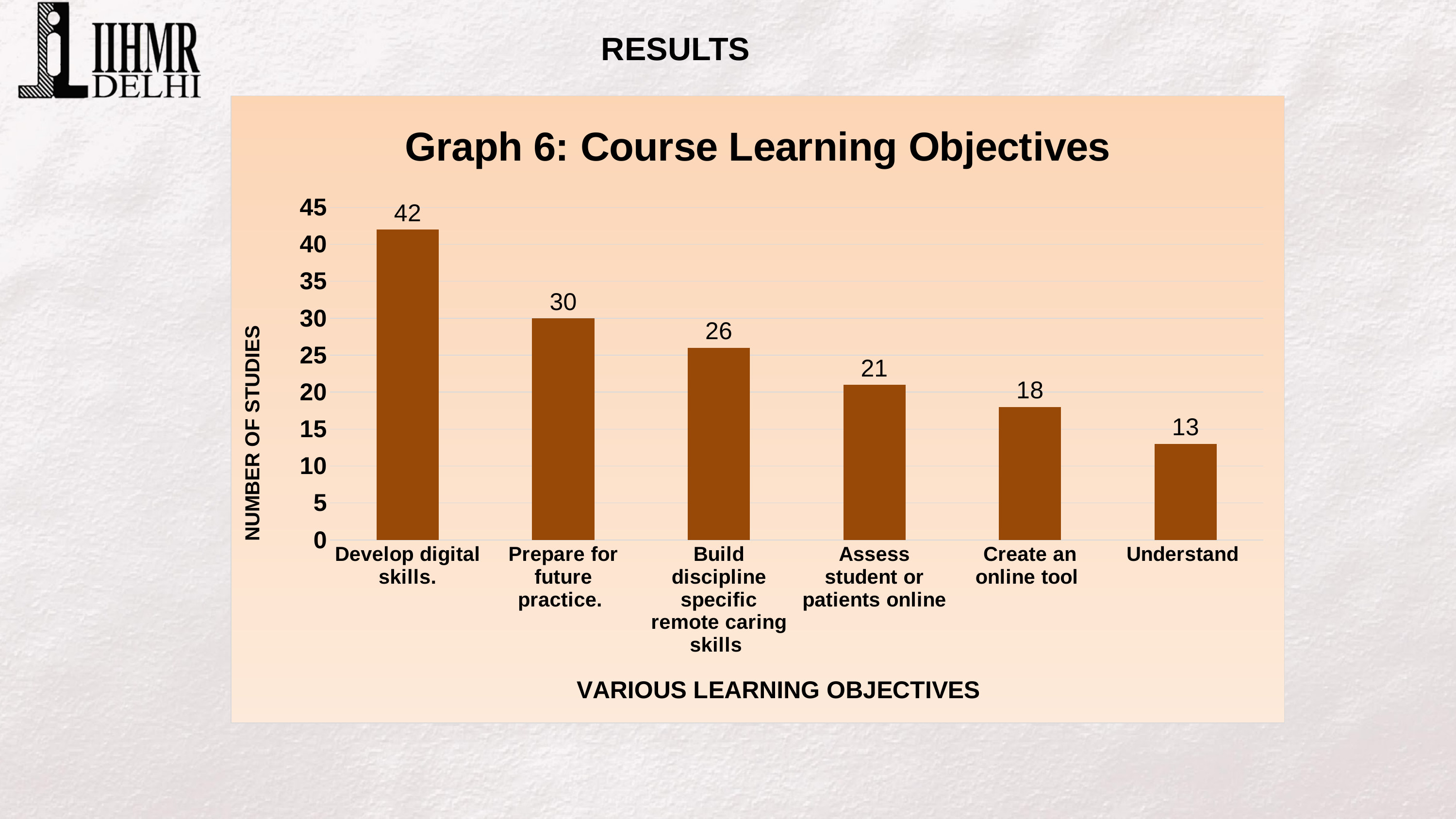
What is the difference in number of studies between 'Prepare for future practice.' and 'Understand'? 17 Do the values rise or fall from left to right along the x axis? Fall Which has more studies: 'Build discipline specific remote caring skills' or 'Create an online tool'? Build discipline specific remote caring skills What kind of chart is Graph 6? Bar chart What is the number of studies for 'Assess student or patients online'? 21 What is the title of the y axis? NUMBER OF STUDIES What is the difference in number of studies between 'Develop digital skills.' and 'Build discipline specific remote caring skills'? 16 Which learning objective has the lowest number of studies? Understand What is the number of studies for 'Develop digital skills.'? 42 What is the number of studies for 'Create an online tool'? 18 Which learning objective has the highest number of studies? Develop digital skills. How many learning objectives are shown on the x axis? 6